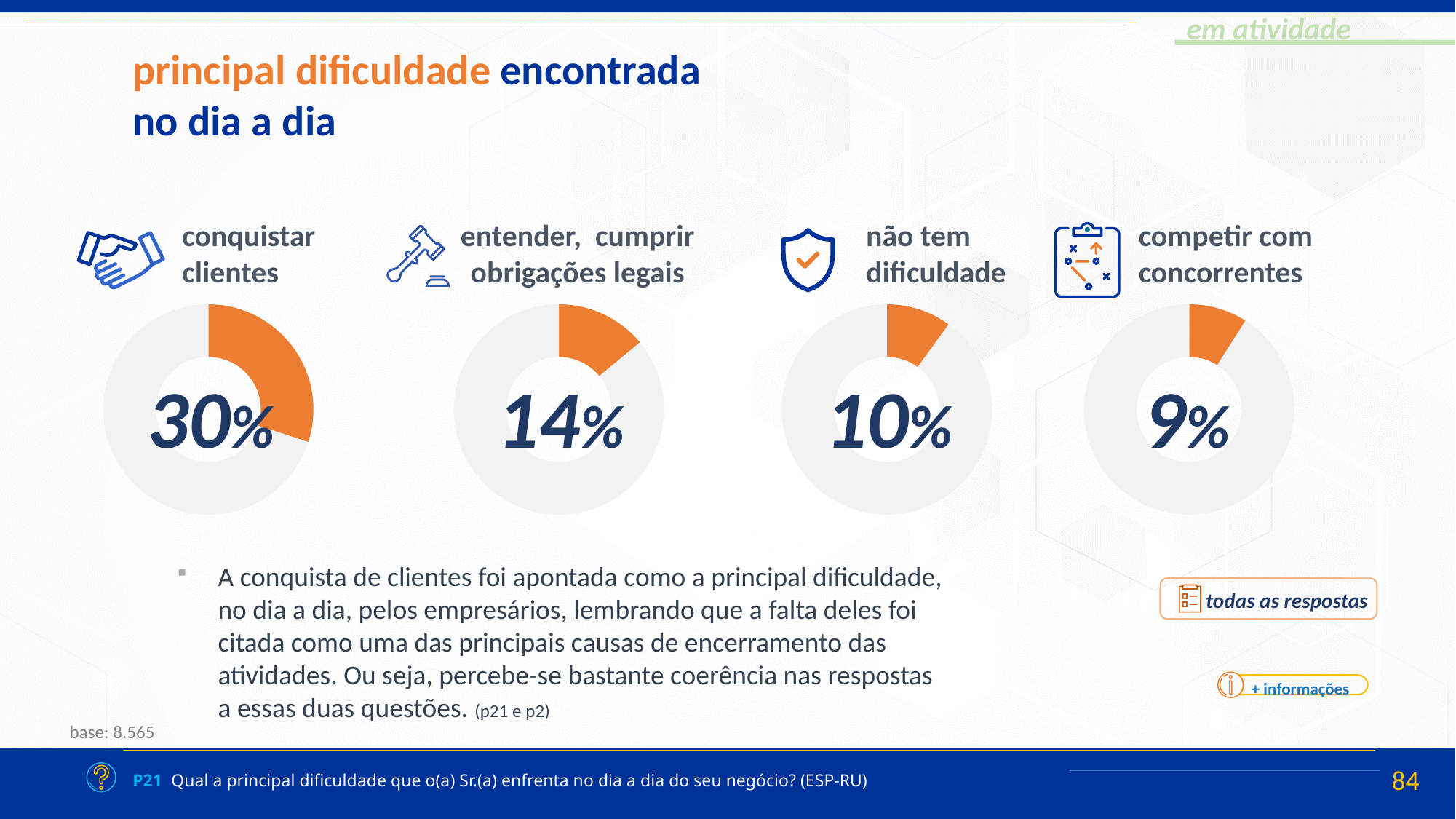
How many donut charts are shown on the slide? 4 Which is larger: the value for 'não tem dificuldade' or for 'competir com concorrentes'? não tem dificuldade What is the difference in percentage points between 'conquistar clientes' and 'entender, cumprir obrigações legais'? 16 What colour is used for the filled portion of each donut chart? orange What percentage is shown for 'competir com concorrentes'? 9% Which difficulty has the highest percentage? conquistar clientes What kind of chart is used to display each percentage? donut chart What percentage is shown for 'entender, cumprir obrigações legais'? 14% What percentage is shown for 'não tem dificuldade'? 10% What is the base (number of respondents) shown on the slide? 8.565 Which category has the lowest percentage? competir com concorrentes What percentage is shown for 'conquistar clientes'? 30%